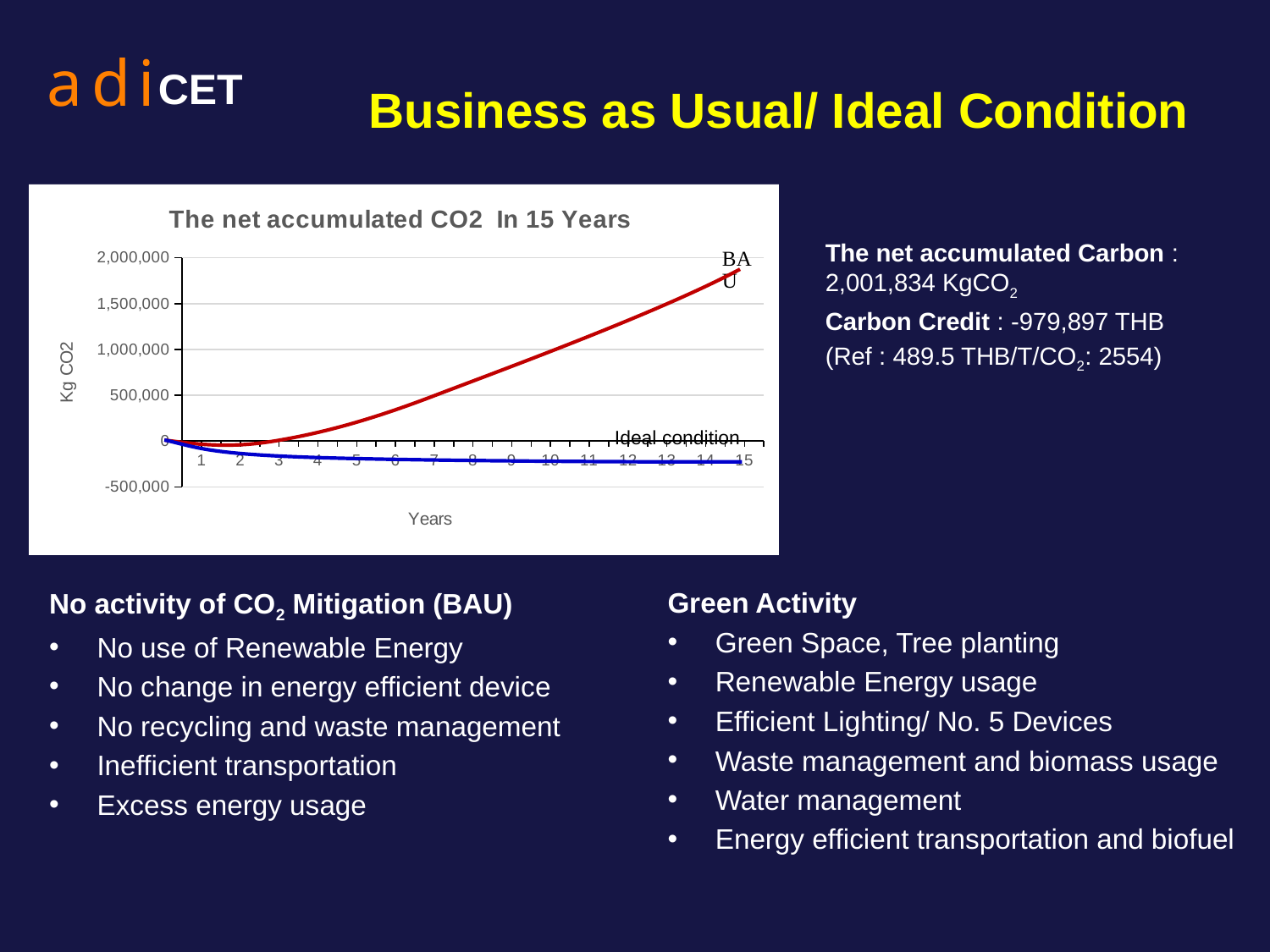
How many series are plotted on the chart? 2 Is the value of the BAU line at year 12 greater or less than 1,000,000? greater Does the BAU line rise or fall as the years increase? Rises What is the title of the chart? The net accumulated CO2 In 15 Years Is the value of the BAU line at year 15 greater or less than 1,500,000? greater What is the lowest value shown on the y axis of the chart? -500,000 What is the highest value shown on the y axis of the chart? 2,000,000 Is the value of the Ideal condition line at year 15 greater or less than 0? less At year 15, which series has the higher value, BAU or Ideal condition? BAU What kind of chart is shown on the slide? Line chart What is the label on the y axis of the chart? Kg CO2 How many years are shown along the x axis of the chart? 15